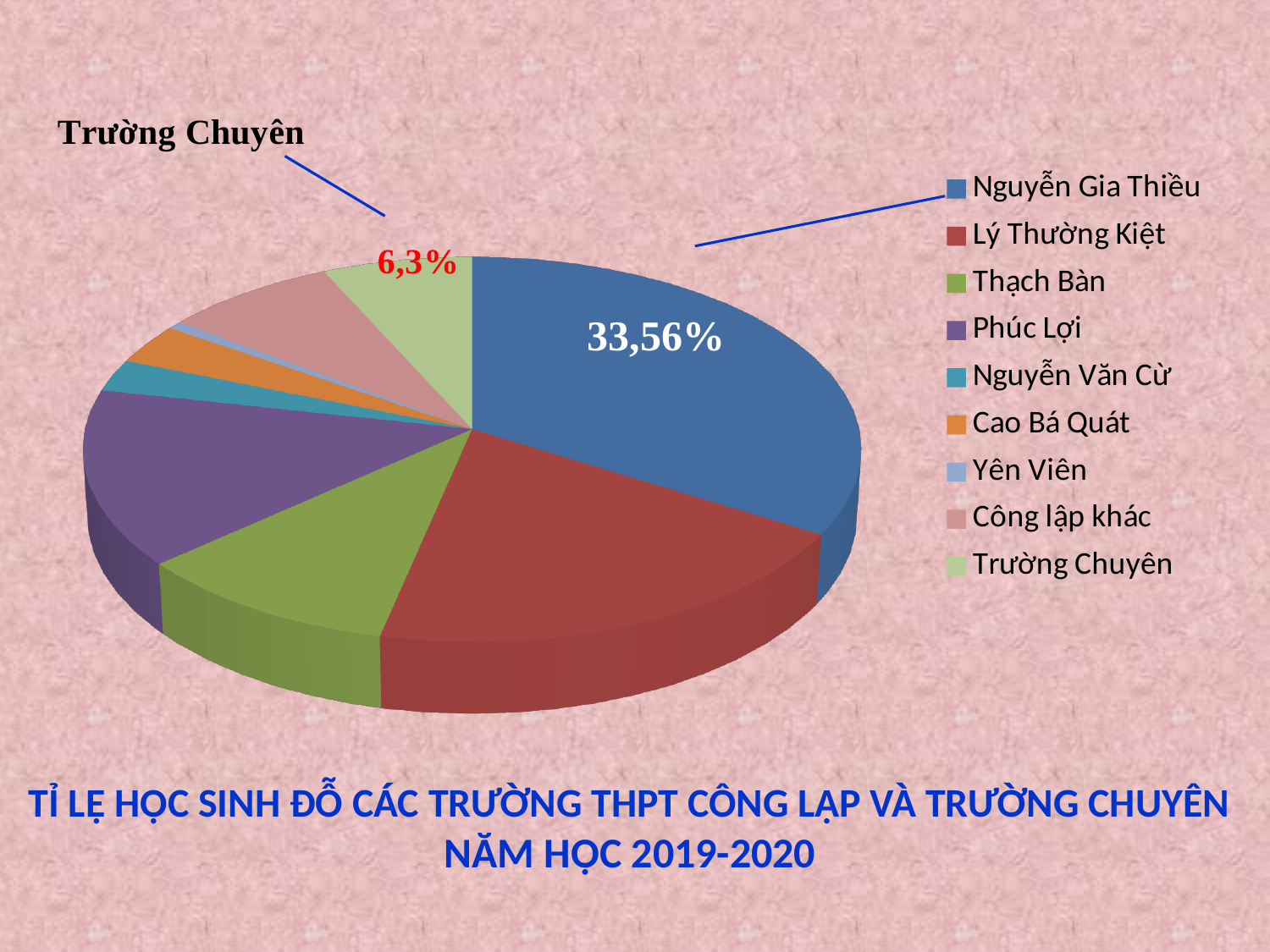
How many categories does the pie chart's legend list? 9 What percentage is shown for Nguyễn Gia Thiều in the pie chart? 33,56% What is the difference in percentage points between the Nguyễn Gia Thiều slice (33,56%) and the Trường Chuyên slice (6,3%)? 27,26% What percentage is shown for Trường Chuyên in the pie chart? 6,3% Which is larger, the slice for Lý Thường Kiệt or the slice for Cao Bá Quát? Lý Thường Kiệt What is the title of the chart shown on the slide? TỈ LỆ HỌC SINH ĐỖ CÁC TRƯỜNG THPT CÔNG LẬP VÀ TRƯỜNG CHUYÊN NĂM HỌC 2019-2020 Which is larger, the slice for Phúc Lợi or the slice for Nguyễn Văn Cừ? Phúc Lợi Which school has the largest slice of the pie chart? Nguyễn Gia Thiều Which category has the smallest slice of the pie chart? Yên Viên What kind of chart is shown on the slide? Pie chart Which is larger, the slice for Nguyễn Gia Thiều or the slice for Trường Chuyên? Nguyễn Gia Thiều What colour is the slice for Nguyễn Gia Thiều in the pie chart? Blue